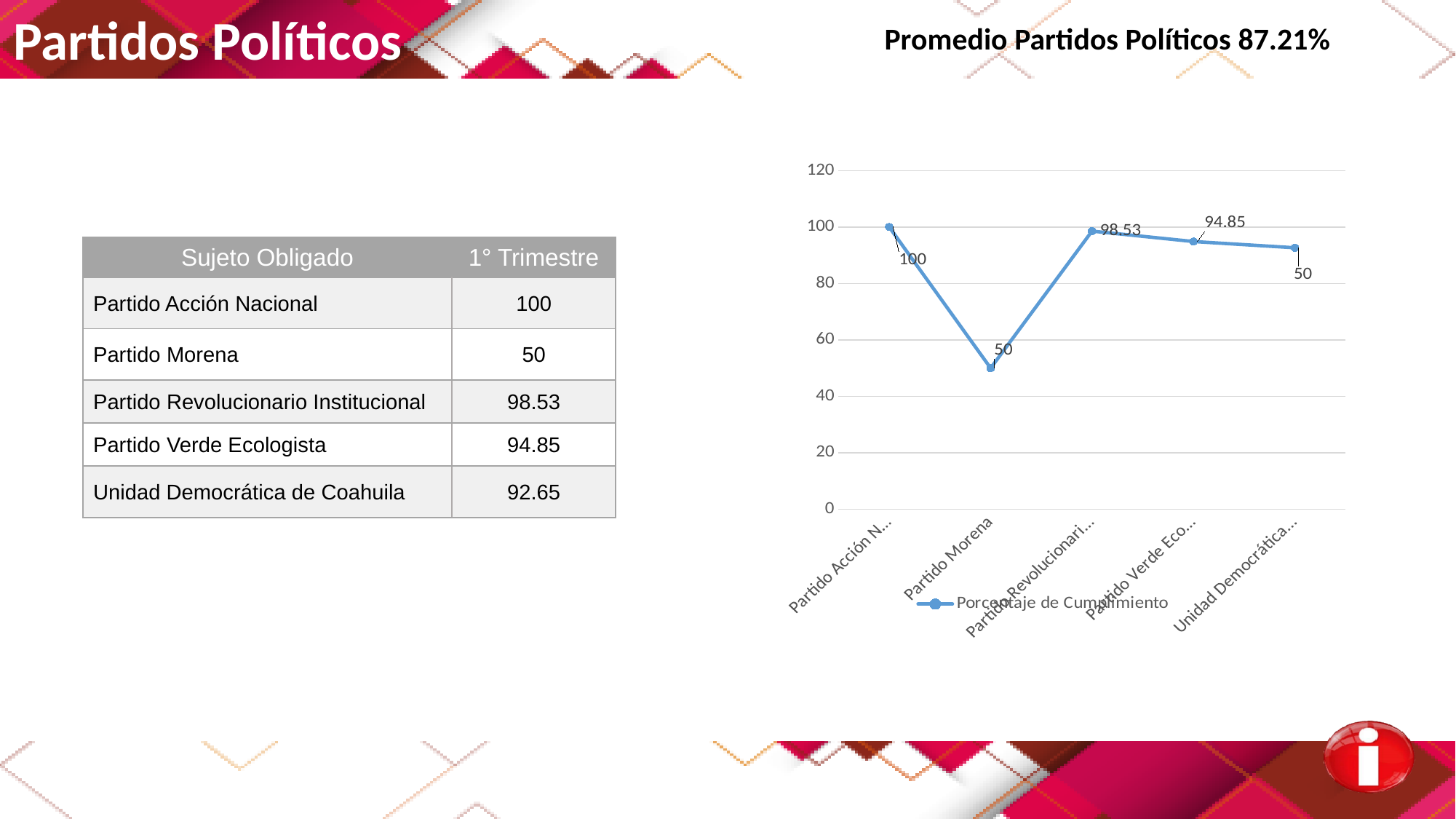
What is the value plotted for Partido Morena? 50 What is the value plotted for Partido Verde Ecologista? 94.85 What is the value plotted for Partido Acción Nacional? 100 What kind of chart is shown on the slide? line chart Which category has the highest value on the chart? Partido Acción Nacional What series name is shown in the chart legend? Porcentaje de Cumplimiento Which is larger, the value for Partido Revolucionario Institucional or for Partido Verde Ecologista? Partido Revolucionario Institucional What is the difference between the values for Partido Acción Nacional and Partido Morena? 50 What is the value plotted for Partido Revolucionario Institucional? 98.53 How many data points are plotted on the line chart? 5 How many series does the chart legend list? 1 Which category has the lowest value on the chart? Partido Morena